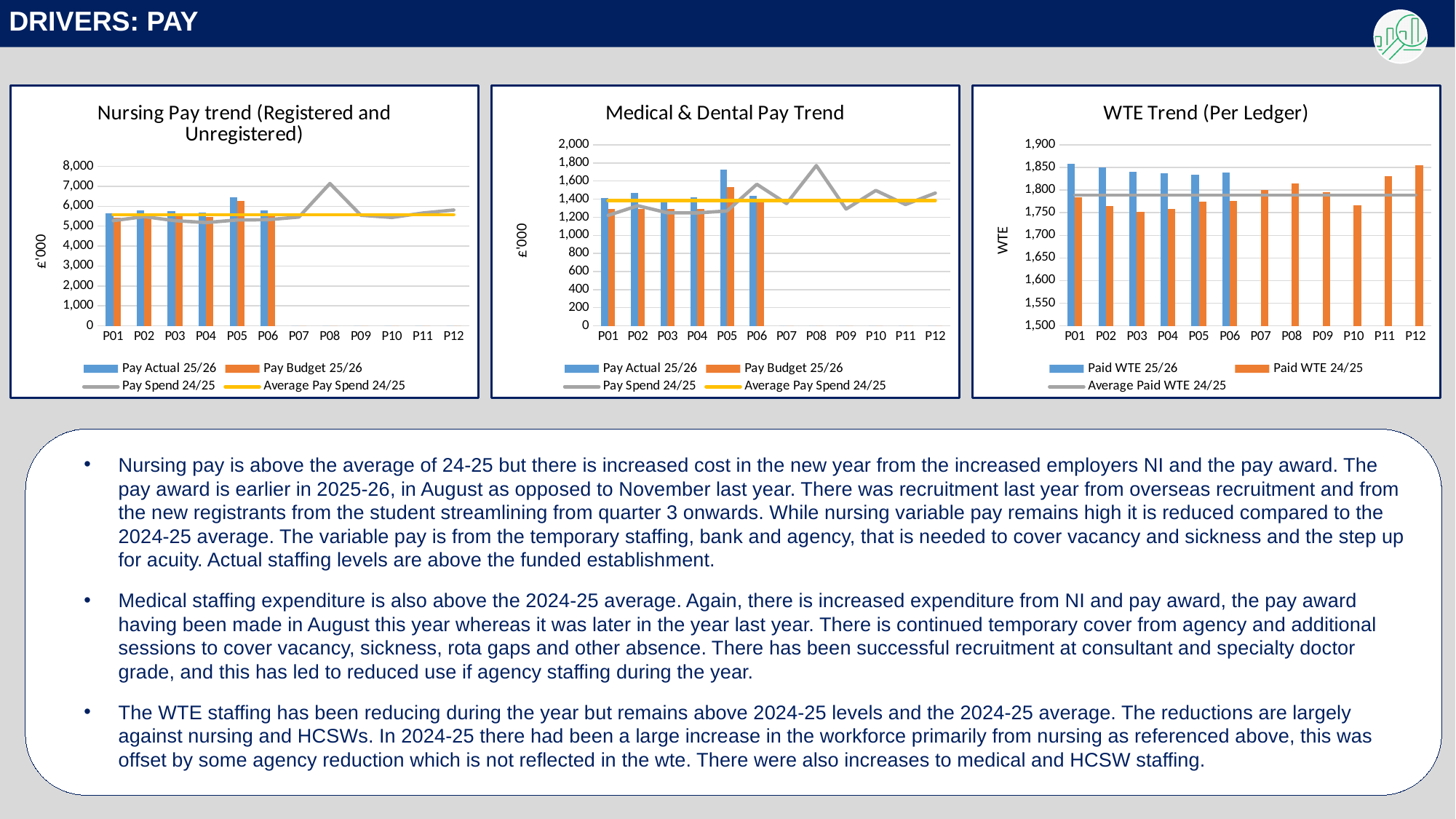
In the 'Medical & Dental Pay Trend' chart, is the Pay Actual 25/26 value for P05 greater or less than 1,600? greater In the 'WTE Trend (Per Ledger)' chart, which is larger for P01: Paid WTE 25/26 or Paid WTE 24/25? Paid WTE 25/26 In the 'Medical & Dental Pay Trend' chart, in which period is Pay Actual 25/26 highest? P05 In the 'Nursing Pay trend (Registered and Unregistered)' chart, how many periods are shown on the x axis? 12 In the 'WTE Trend (Per Ledger)' chart, in which period is Paid WTE 24/25 highest? P12 In the 'Nursing Pay trend (Registered and Unregistered)' chart, in which period is Pay Actual 25/26 highest? P05 In the 'WTE Trend (Per Ledger)' chart, how many series does the legend list? 3 In the 'Nursing Pay trend (Registered and Unregistered)' chart, is the Pay Actual 25/26 value for P05 greater or less than 6,000? greater In the 'Nursing Pay trend (Registered and Unregistered)' chart, how many series does the legend list? 4 What kind of chart is the 'Nursing Pay trend (Registered and Unregistered)' chart? Bar chart with line series In the 'Medical & Dental Pay Trend' chart, what is the y-axis label? £'000